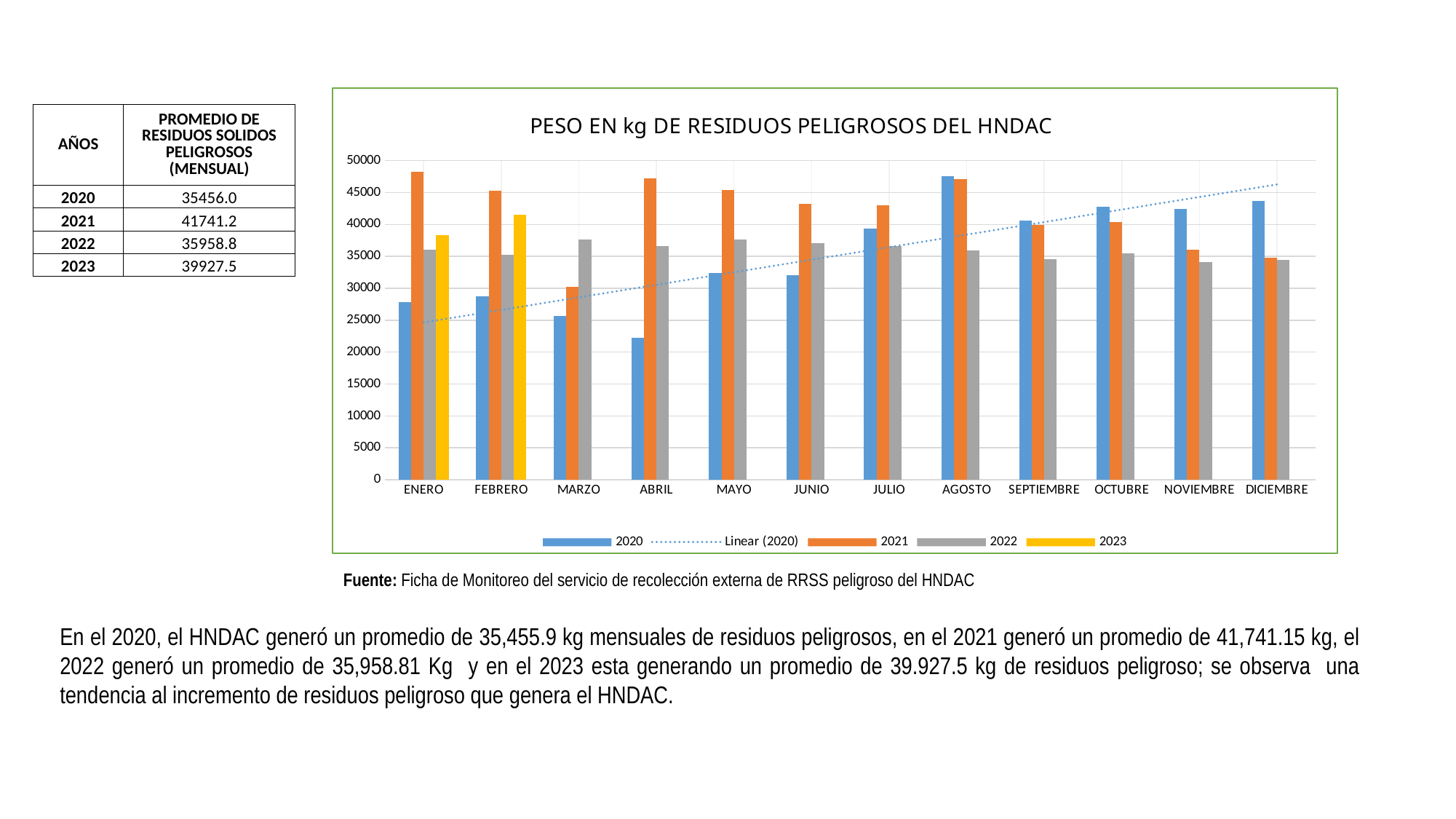
Is the value for 2020 in ABRIL greater or less than 25000? less Is the value for 2023 in FEBRERO greater or less than 40000? greater What kind of chart is shown on the slide? bar chart Is the value for 2021 in ENERO greater or less than 45000? greater What is the title of the chart? PESO EN kg DE RESIDUOS PELIGROSOS DEL HNDAC How many months are shown on the x axis of the chart? 12 In DICIEMBRE, which is larger: the 2020 value or the 2021 value? 2020 Which series is shown in yellow in the chart? 2023 In which month is the 2020 value lowest? ABRIL In which month is the 2020 value highest? AGOSTO How many entries does the chart legend list? 5 In which month is the 2021 value lowest? MARZO